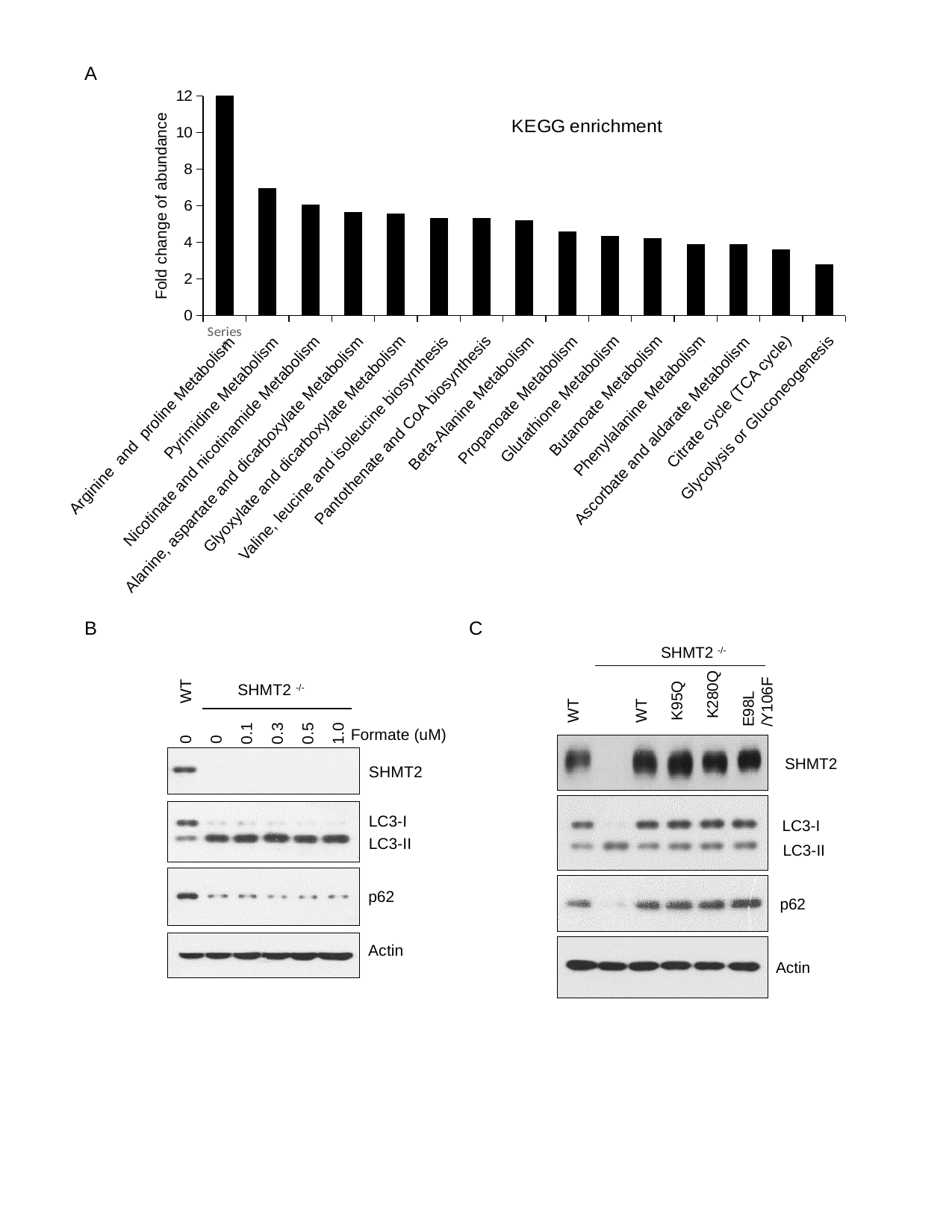
What is the title of the chart in panel A? KEGG enrichment In the KEGG enrichment chart, which pathway has the lowest fold change of abundance? Glycolysis or Gluconeogenesis What is the y-axis label of the KEGG enrichment chart? Fold change of abundance In the KEGG enrichment chart, which pathway has the highest fold change of abundance? Arginine and proline Metabolism What kind of chart is shown in panel A? bar chart In the KEGG enrichment chart, how many pathway categories are plotted? 15 In the KEGG enrichment chart, do the bar values rise or fall from left to right along the x axis? fall In the KEGG enrichment chart, which has the larger fold change of abundance: Pyrimidine Metabolism or Glutathione Metabolism? Pyrimidine Metabolism In the KEGG enrichment chart, is the value for Glycolysis or Gluconeogenesis greater or less than 2? greater In the KEGG enrichment chart, is the value for Pyrimidine Metabolism greater or less than 6? greater In the KEGG enrichment chart, is the value for Citrate cycle (TCA cycle) greater or less than 4? less